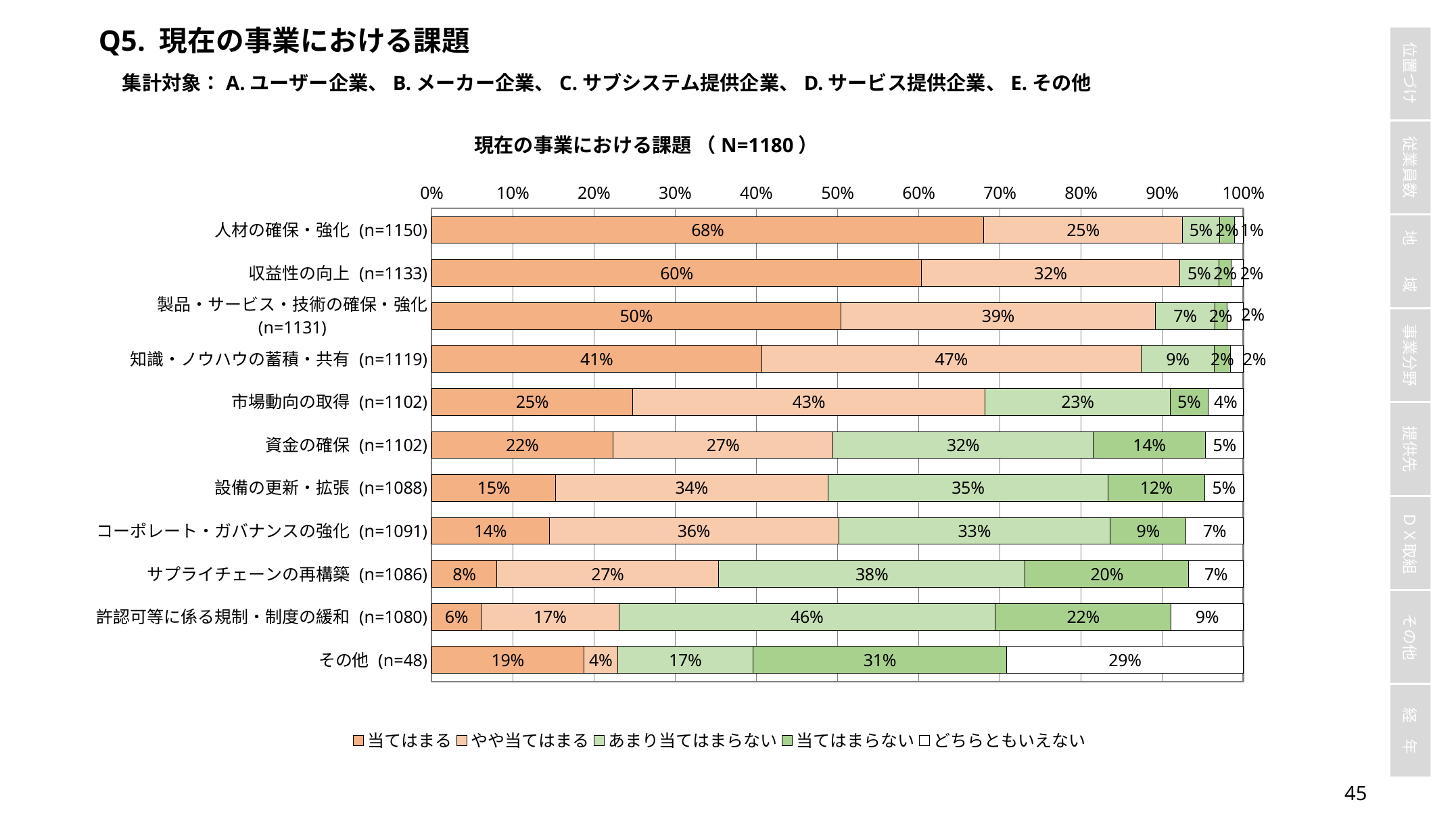
Which category has the highest 当てはまる value? 人材の確保・強化 What is the N value shown in the chart title? N=1180 How many categories are shown in the chart? 11 What is the difference between the 当てはまる values for 収益性の向上 and 製品・サービス・技術の確保・強化? 10% Which category has the lowest 当てはまる value? 許認可等に係る規制・制度の緩和 What kind of chart is shown? Stacked bar chart What is the どちらともいえない value for その他? 29% Which has a larger あまり当てはまらない value, 資金の確保 or サプライチェーンの再構築? サプライチェーンの再構築 What is the やや当てはまる value for 知識・ノウハウの蓄積・共有? 47% What is the 当てはまらない value for 許認可等に係る規制・制度の緩和? 22% What is the 当てはまる value for 人材の確保・強化? 68% How many series does the legend list? 5